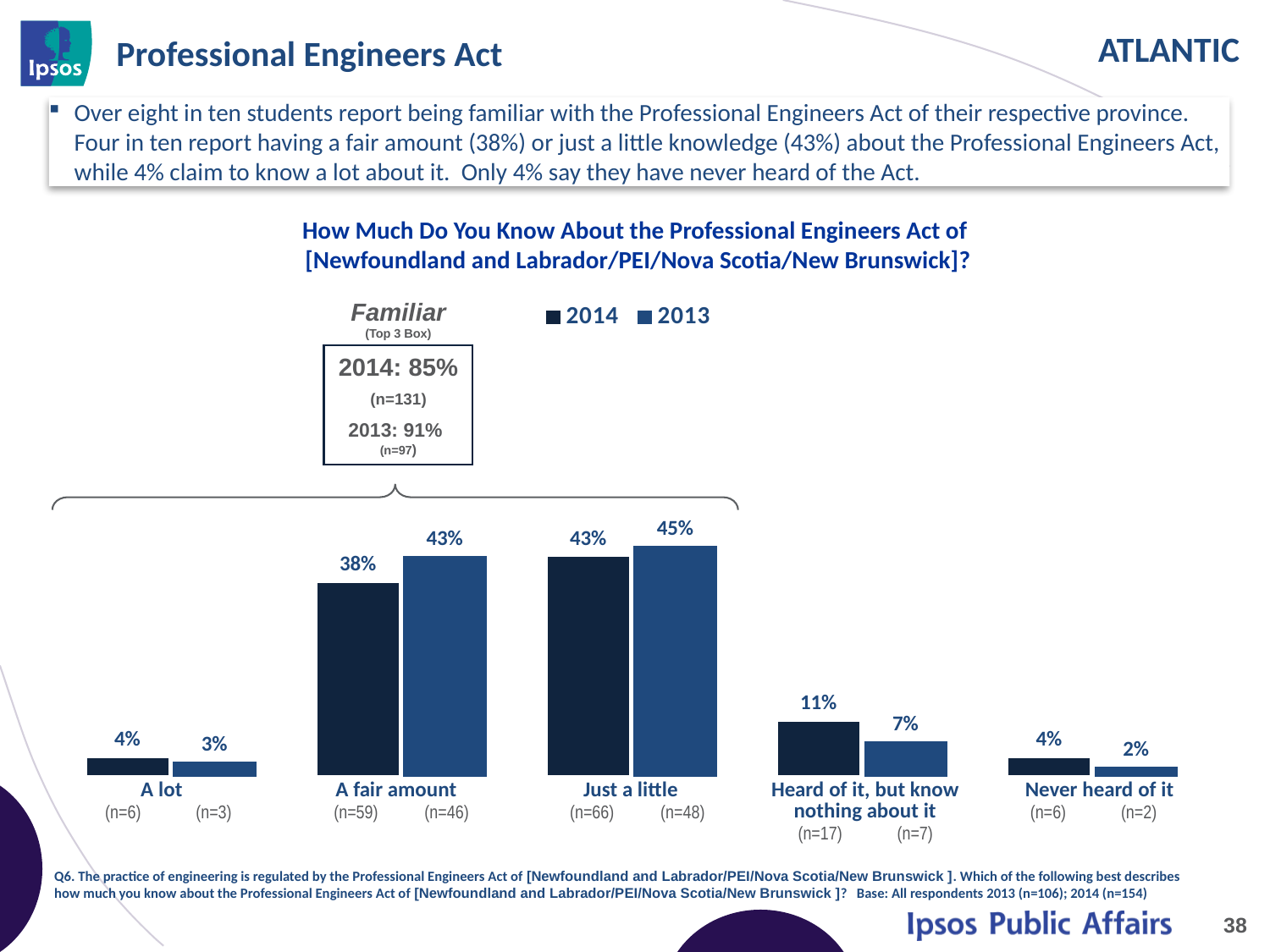
What is the 2013 value for "Just a little"? 45% What kind of chart is shown? Bar chart Which is larger for "Heard of it, but know nothing about it": the 2014 value or the 2013 value? 2014 What is the 2013 value for "Never heard of it"? 2% What is the Familiar (Top 3 Box) value for 2013? 91% Which category has the highest 2014 value? Just a little How many categories are shown on the x axis? 5 How many series does the legend list? 2 Which category has the lowest 2013 value? Never heard of it What is the difference between the 2013 and 2014 values for "A fair amount"? 5% What is the 2014 value for "Heard of it, but know nothing about it"? 11% What is the 2014 value for "A fair amount"? 38%